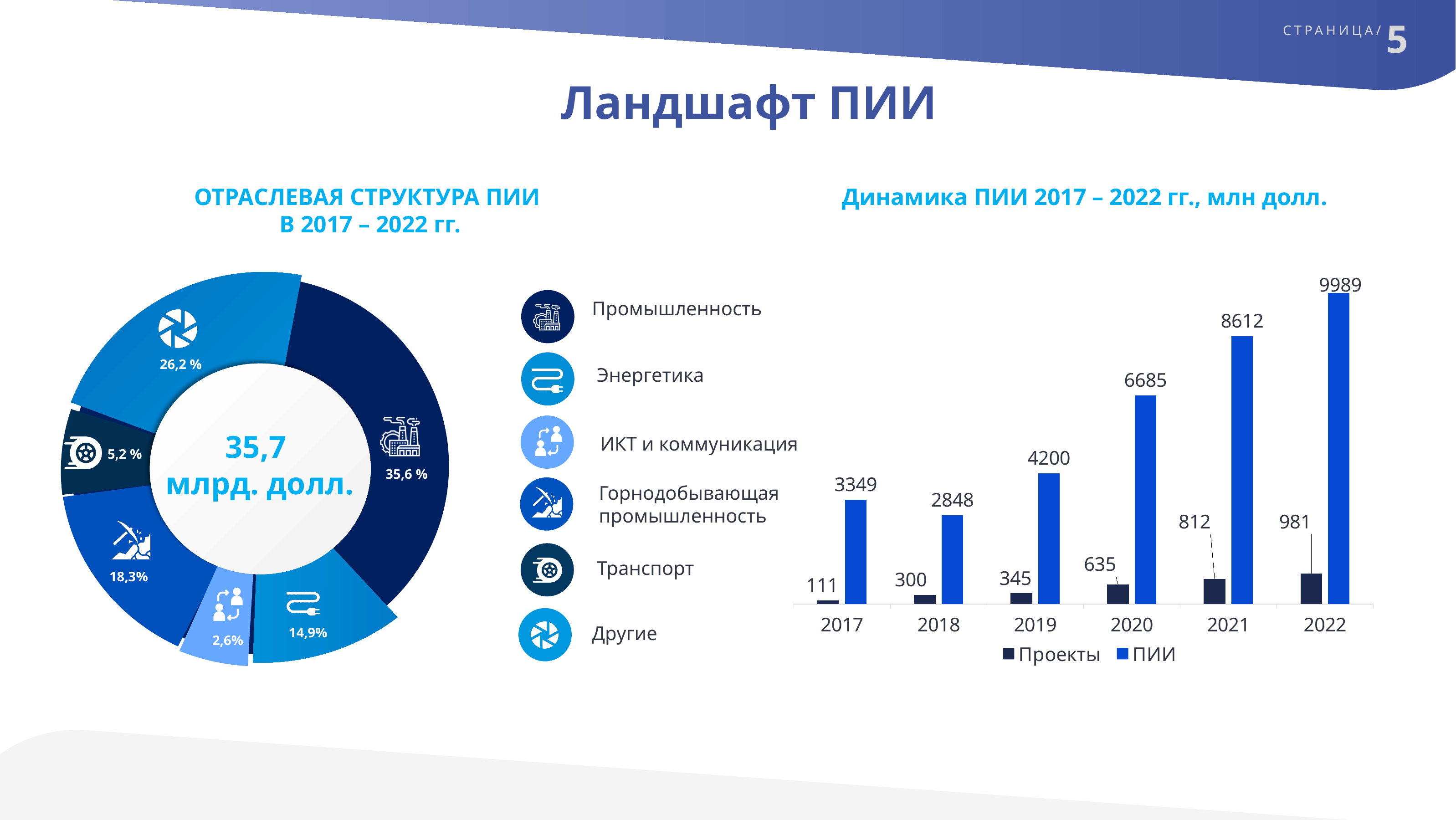
In the chart 'Динамика ПИИ 2017 – 2022 гг., млн долл.', what is the difference between the ПИИ values for 2022 and 2021? 1377 In the chart 'Динамика ПИИ 2017 – 2022 гг., млн долл.', how many series does the legend list? 2 What kind of chart is 'ОТРАСЛЕВАЯ СТРУКТУРА ПИИ В 2017 – 2022 гг.'? Pie (donut) chart In the chart 'Динамика ПИИ 2017 – 2022 гг., млн долл.', do the Проекты values rise or fall from 2017 to 2022? rise In the chart 'Динамика ПИИ 2017 – 2022 гг., млн долл.', which year has the lowest ПИИ value? 2018 In the chart 'ОТРАСЛЕВАЯ СТРУКТУРА ПИИ В 2017 – 2022 гг.', what share does Горнодобывающая промышленность have? 18,3% In the chart 'Динамика ПИИ 2017 – 2022 гг., млн долл.', which year has the highest ПИИ value? 2022 In the chart 'Динамика ПИИ 2017 – 2022 гг., млн долл.', which is larger: the ПИИ value for 2017 or for 2018? 2017 In the chart 'ОТРАСЛЕВАЯ СТРУКТУРА ПИИ В 2017 – 2022 гг.', which sector has the largest share? Промышленность In the chart 'Динамика ПИИ 2017 – 2022 гг., млн долл.', how many years are shown on the x axis? 6 In the chart 'Динамика ПИИ 2017 – 2022 гг., млн долл.', what is the value of Проекты for 2018? 300 In the chart 'Динамика ПИИ 2017 – 2022 гг., млн долл.', what is the value of ПИИ for 2020? 6685